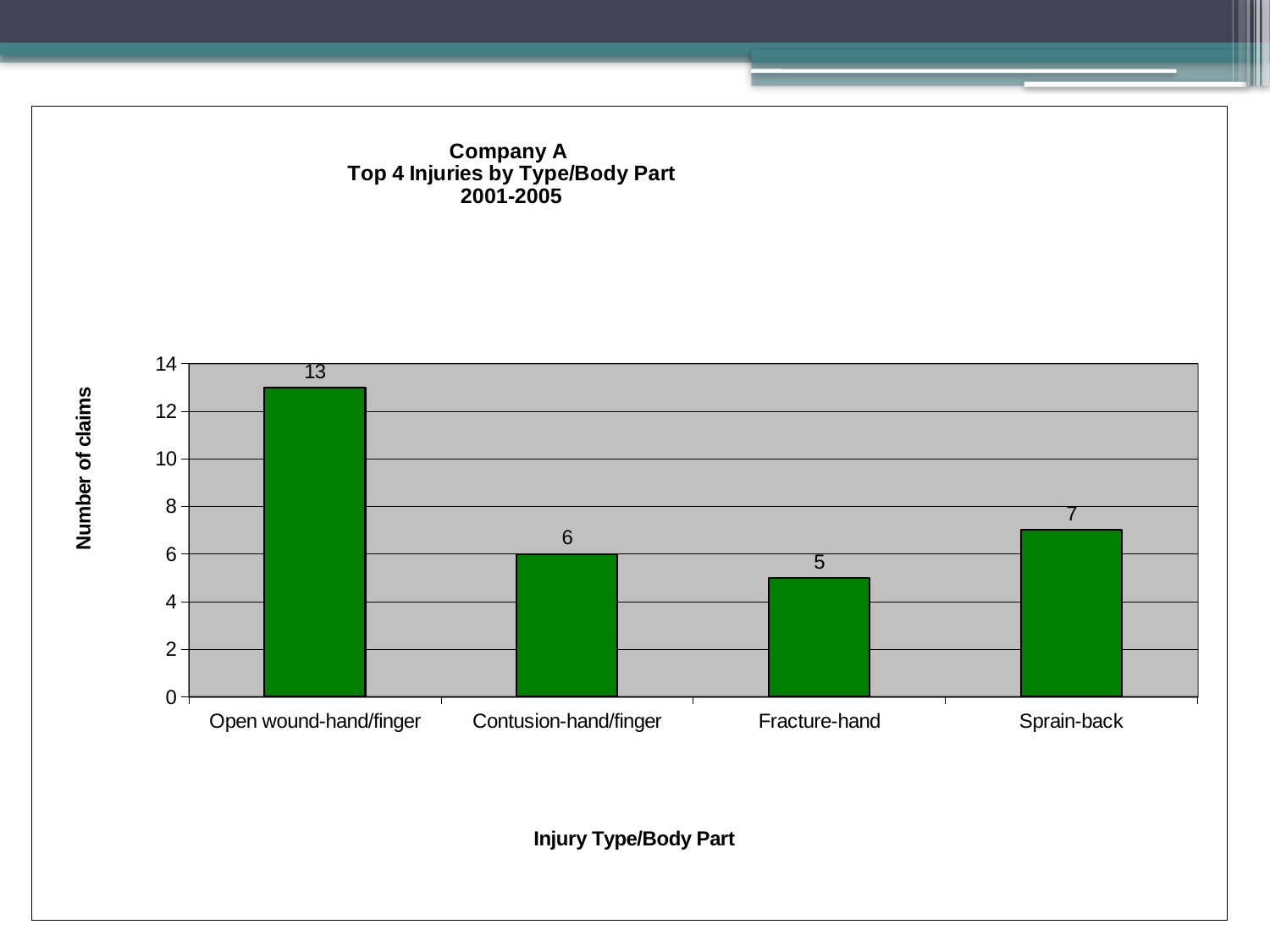
What time period does the chart title say the data covers? 2001-2005 Which injury type has the highest number of claims? Open wound-hand/finger What is the number of claims for Sprain-back? 7 What is the difference in claims between Open wound-hand/finger and Sprain-back? 6 What kind of chart is shown on the slide? Bar chart Which has more claims, Contusion-hand/finger or Sprain-back? Sprain-back What is the number of claims for Contusion-hand/finger? 6 Is the value for Fracture-hand greater or less than 6? less How many injury type categories are shown on the chart? 4 How many claims are shown for Open wound-hand/finger? 13 Which injury type has the lowest number of claims? Fracture-hand What is the label of the vertical axis? Number of claims